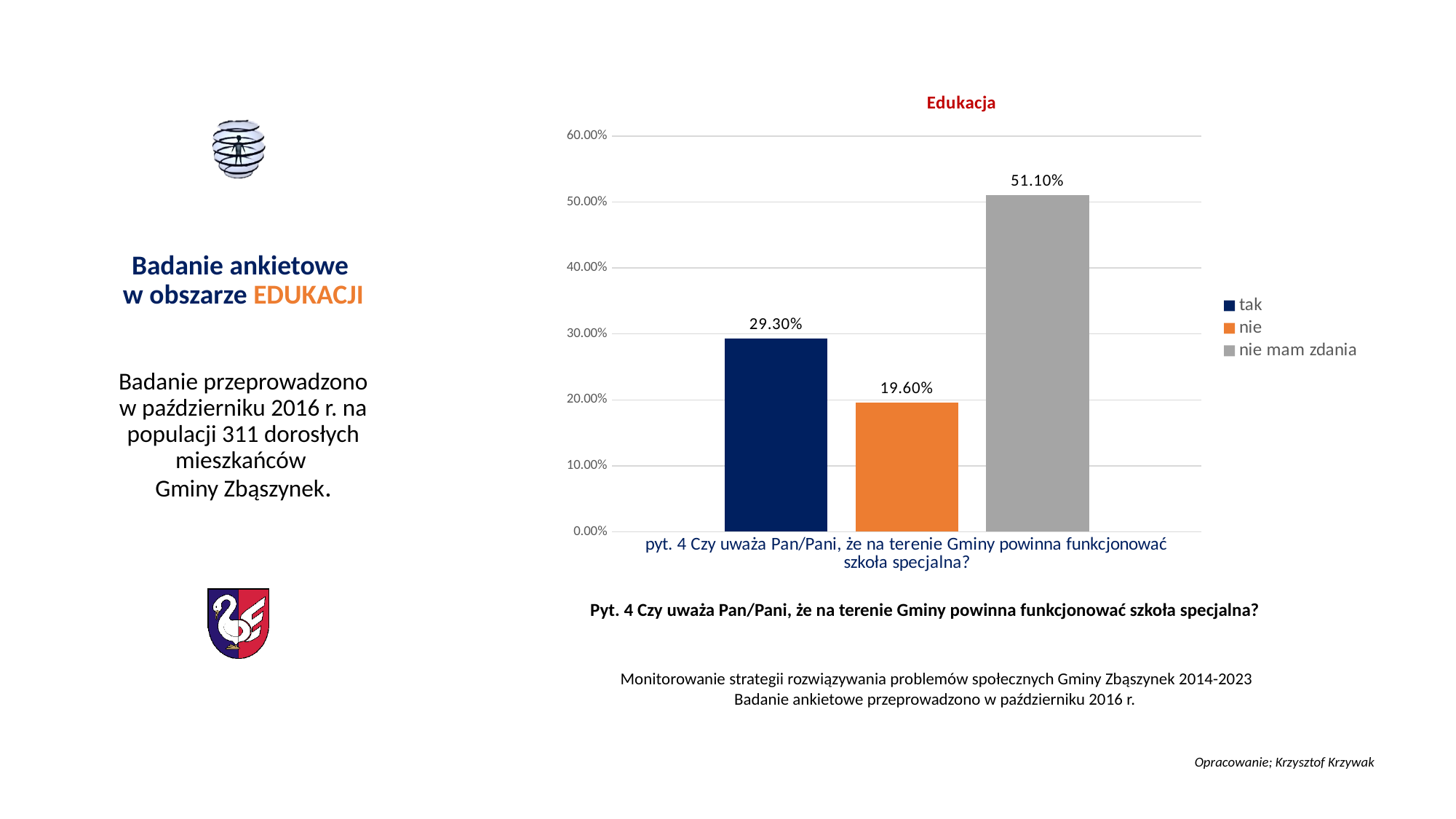
What is the value for "nie mam zdania"? 51.10% What is the value for "tak"? 29.30% How many series does the legend list? 3 What is the title of the chart? Edukacja What is the difference between the values for "nie mam zdania" and "tak"? 21.80% Which is larger, the value for "tak" or the value for "nie"? tak Which response has the highest value? nie mam zdania What kind of chart is shown on the slide? bar chart Is the value for "nie mam zdania" greater or less than 50.00%? greater Which response has the lowest value? nie What is the value for "nie"? 19.60% What is the difference between the values for "tak" and "nie"? 9.70%